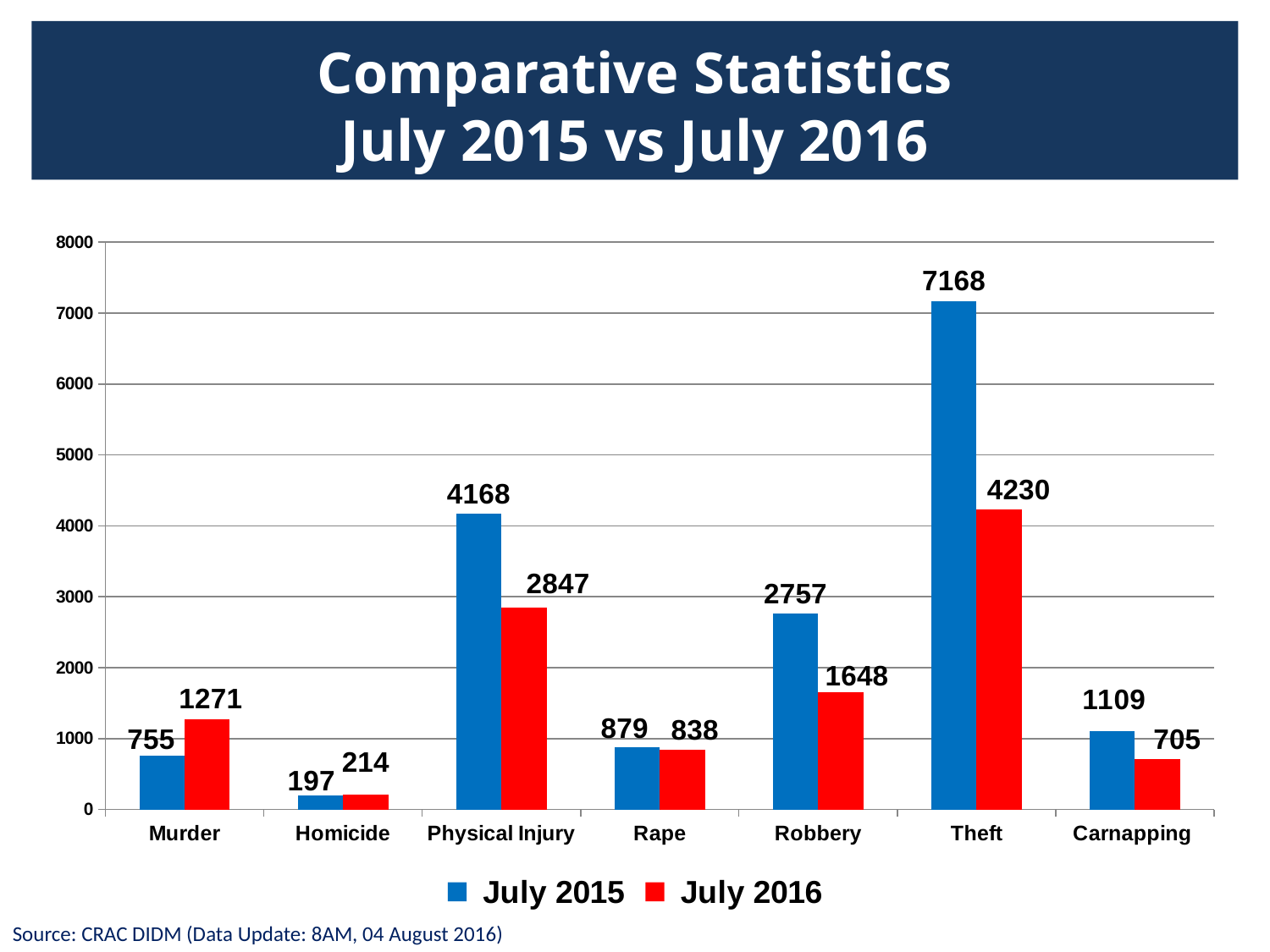
Which category has the highest July 2015 value? Theft What kind of chart is shown on the slide? Bar chart Which is larger for Carnapping: the July 2015 value or the July 2016 value? July 2015 What is the July 2016 value for Murder? 1271 What is the difference between the July 2015 and July 2016 values for Physical Injury? 1321 Is the July 2016 value for Theft greater or less than 4000? greater Which category has the lowest July 2016 value? Homicide How many crime categories are shown on the x axis? 7 Which colour represents July 2016 in the chart? Red What is the July 2015 value for Theft? 7168 What is the July 2016 value for Robbery? 1648 How many series does the legend list? 2